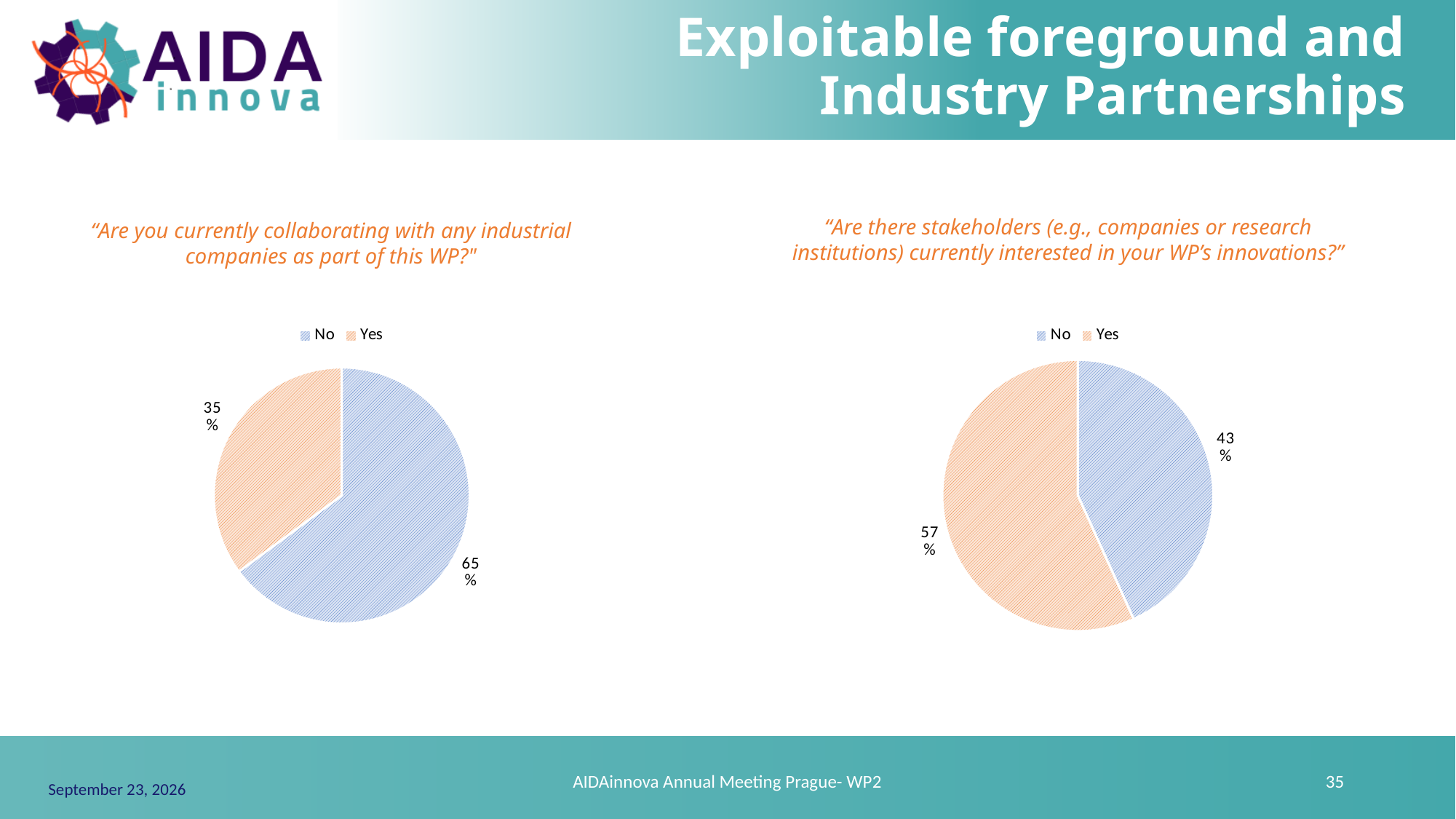
How many entries does the legend of the left pie chart list? 2 In the left pie chart (collaborating with industrial companies), what share of responses is 'Yes'? 35% How many slices does the right pie chart have? 2 In the right pie chart, which response has the larger share, 'No' or 'Yes'? Yes In the right pie chart (stakeholders interested in innovations), what share of responses is 'No'? 43% In the left pie chart, which response has the larger share, 'No' or 'Yes'? No In the left pie chart (collaborating with industrial companies), what share of responses is 'No'? 65% What type of chart is used on the left of the slide? Pie chart In the right pie chart, which colour represents the 'Yes' slice? Orange In the right pie chart (stakeholders interested in innovations), what share of responses is 'Yes'? 57% In the right pie chart, what is the difference in percentage points between the 'Yes' and 'No' shares? 14 In the left pie chart, what is the difference in percentage points between the 'No' and 'Yes' shares? 30